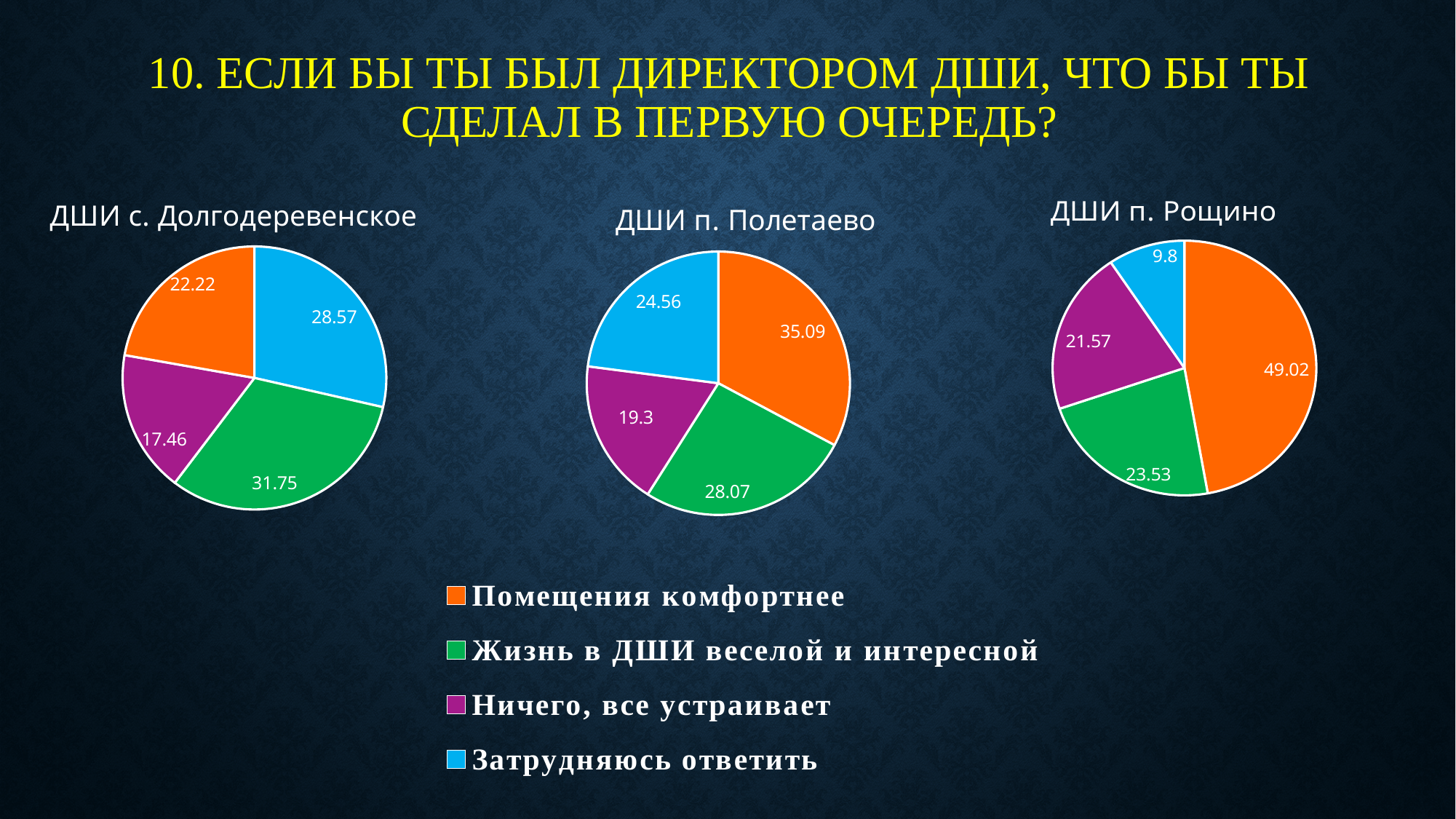
In the chart titled "ДШИ с. Долгодеревенское", which category has the smallest slice? Ничего, все устраивает How many pie charts are shown on the slide? 3 In the chart titled "ДШИ п. Рощино", which is larger: "Жизнь в ДШИ веселой и интересной" or "Ничего, все устраивает"? Жизнь в ДШИ веселой и интересной In the chart titled "ДШИ п. Полетаево", what is the difference between the values for "Помещения комфортнее" and "Затрудняюсь ответить"? 10.53 How many categories does the legend list? 4 In the chart titled "ДШИ п. Рощино", which category has the largest slice? Помещения комфортнее What type of chart is used for "ДШИ п. Полетаево"? Pie chart In the chart titled "ДШИ п. Полетаево", what is the value for "Помещения комфортнее"? 35.09 In the chart titled "ДШИ п. Рощино", what is the value for "Затрудняюсь ответить"? 9.8 In the chart titled "ДШИ с. Долгодеревенское", what is the value for "Жизнь в ДШИ веселой и интересной"? 31.75 In the chart titled "ДШИ п. Полетаево", which category has the smallest slice? Ничего, все устраивает